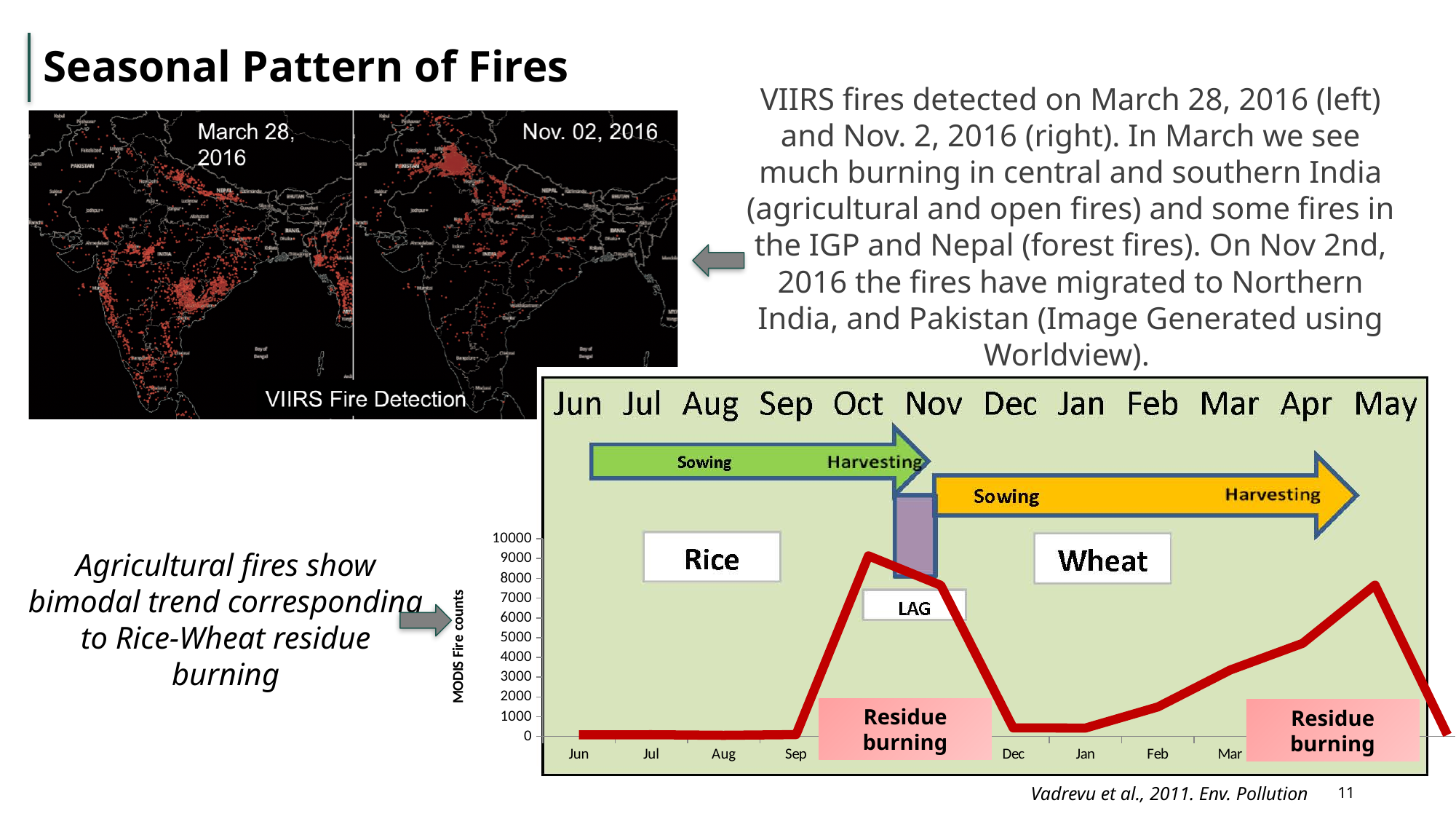
What kind of chart is the MODIS Fire counts chart at the bottom right of the slide? line chart Which crop is labelled over the Jun–Nov part of the fire counts chart? Rice How many months are listed along the top of the fire counts chart? 12 Is the MODIS fire count in Oct greater or less than 8000? greater Which peak is higher on the fire counts chart, the one in Oct or the one in Apr? Oct In which month does the MODIS fire count reach its highest value? Oct Is the MODIS fire count in Jun greater or less than 1000? less Is the MODIS fire count in Apr greater or less than 7000? less What is the label on the vertical axis of the fire counts chart? MODIS Fire counts Do the MODIS fire counts rise or fall from Jan to Apr? rise Do the MODIS fire counts rise or fall from Oct to Dec? fall